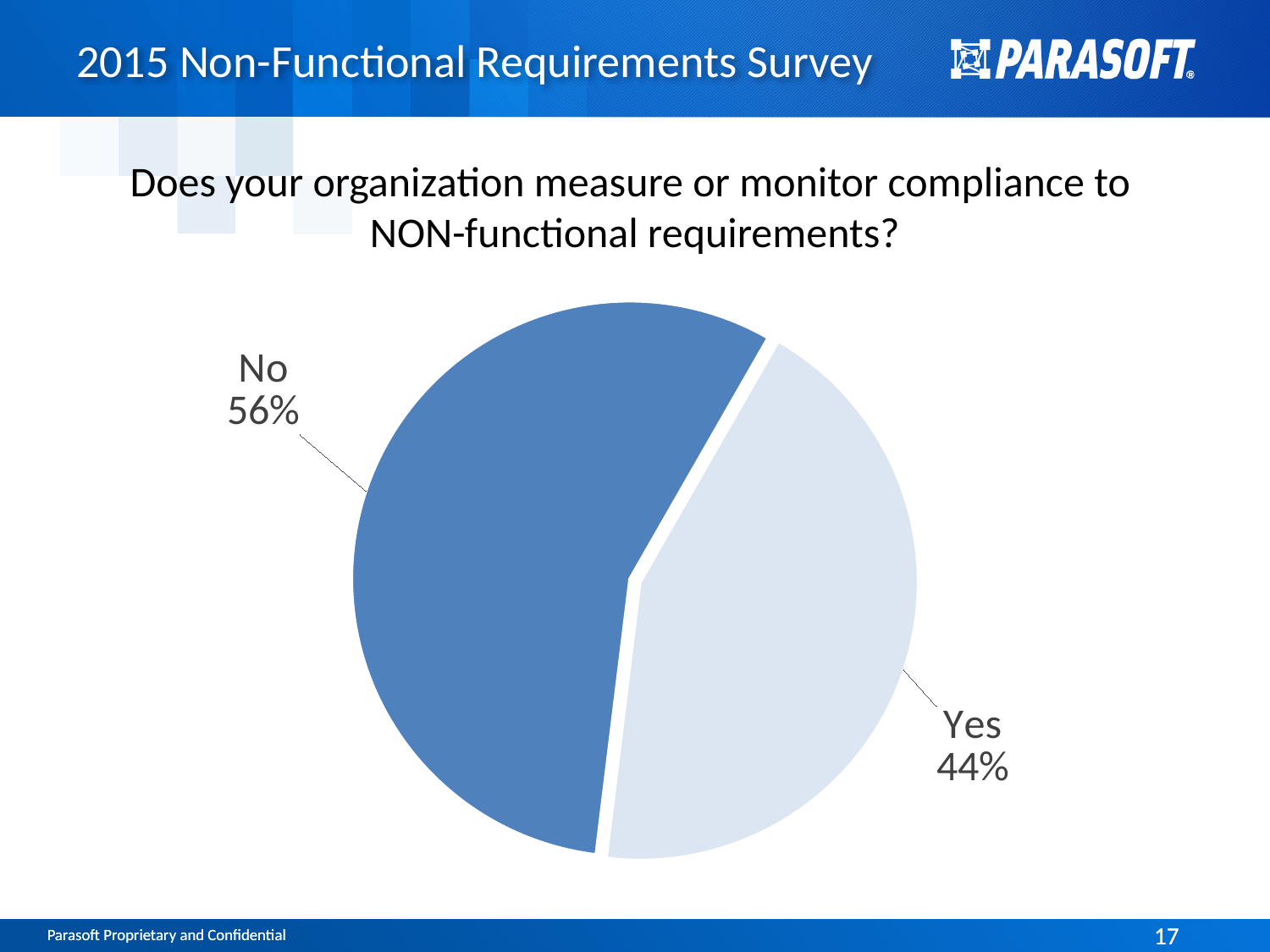
How many slices does the pie chart have? 2 What share of the pie does the "Yes" slice represent? 44% What question does the pie chart answer? Does your organization measure or monitor compliance to NON-functional requirements? Which is larger, the "Yes" slice or the "No" slice? No Which response has the largest share of the pie? No Which slice is shown in the darker blue colour? No What percentage of respondents answered "Yes"? 44% What is the difference in percentage points between the "No" and "Yes" slices? 12 What percentage of respondents answered "No"? 56% What kind of chart is shown on the slide? Pie chart Which response has the smallest share of the pie? Yes